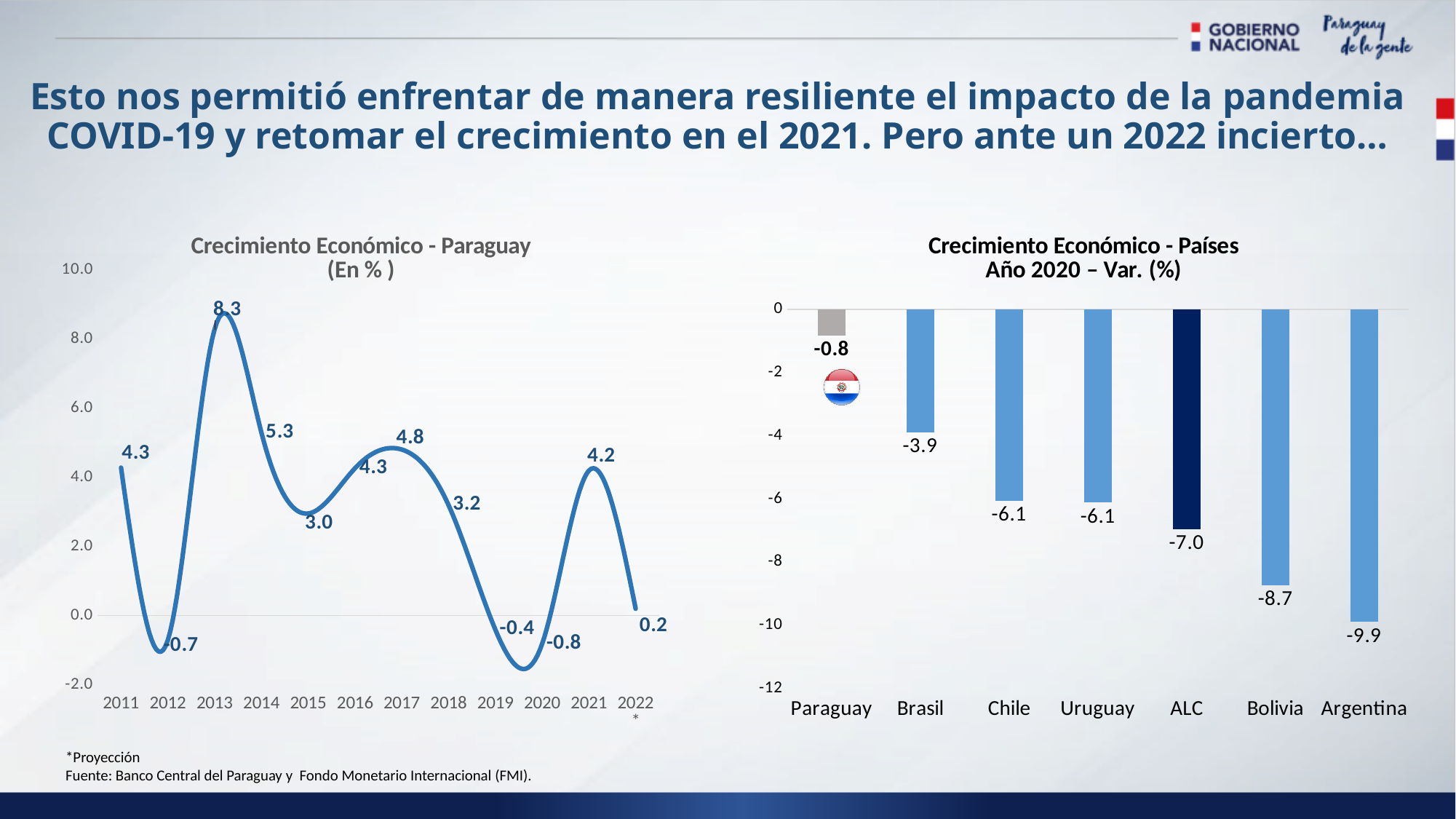
In the 'Crecimiento Económico - Paraguay' chart, what is the difference between the 2021 value and the 2020 value? 5.0 What type of chart is 'Crecimiento Económico - Paraguay'? Line chart In the 'Crecimiento Económico - Paraguay' chart, which year has the highest value? 2013 In the 'Crecimiento Económico - Paraguay' chart, which year has the lowest value? 2020 What type of chart is 'Crecimiento Económico - Países'? Bar chart In the 'Crecimiento Económico - Paraguay' chart, what is the value for 2020? -0.8 In the 'Crecimiento Económico - Países' chart, which country has the lowest value? Argentina In the 'Crecimiento Económico - Países' chart, what is the difference between the values for Paraguay and ALC? 6.2 In the 'Crecimiento Económico - Países' chart, what is the value for Argentina? -9.9 In the 'Crecimiento Económico - Paraguay' chart, how many years are plotted? 12 In the 'Crecimiento Económico - Paraguay' chart, what was the growth value in 2013? 8.3 In the 'Crecimiento Económico - Países' chart, which is larger, the value for Brasil or the value for Bolivia? Brasil